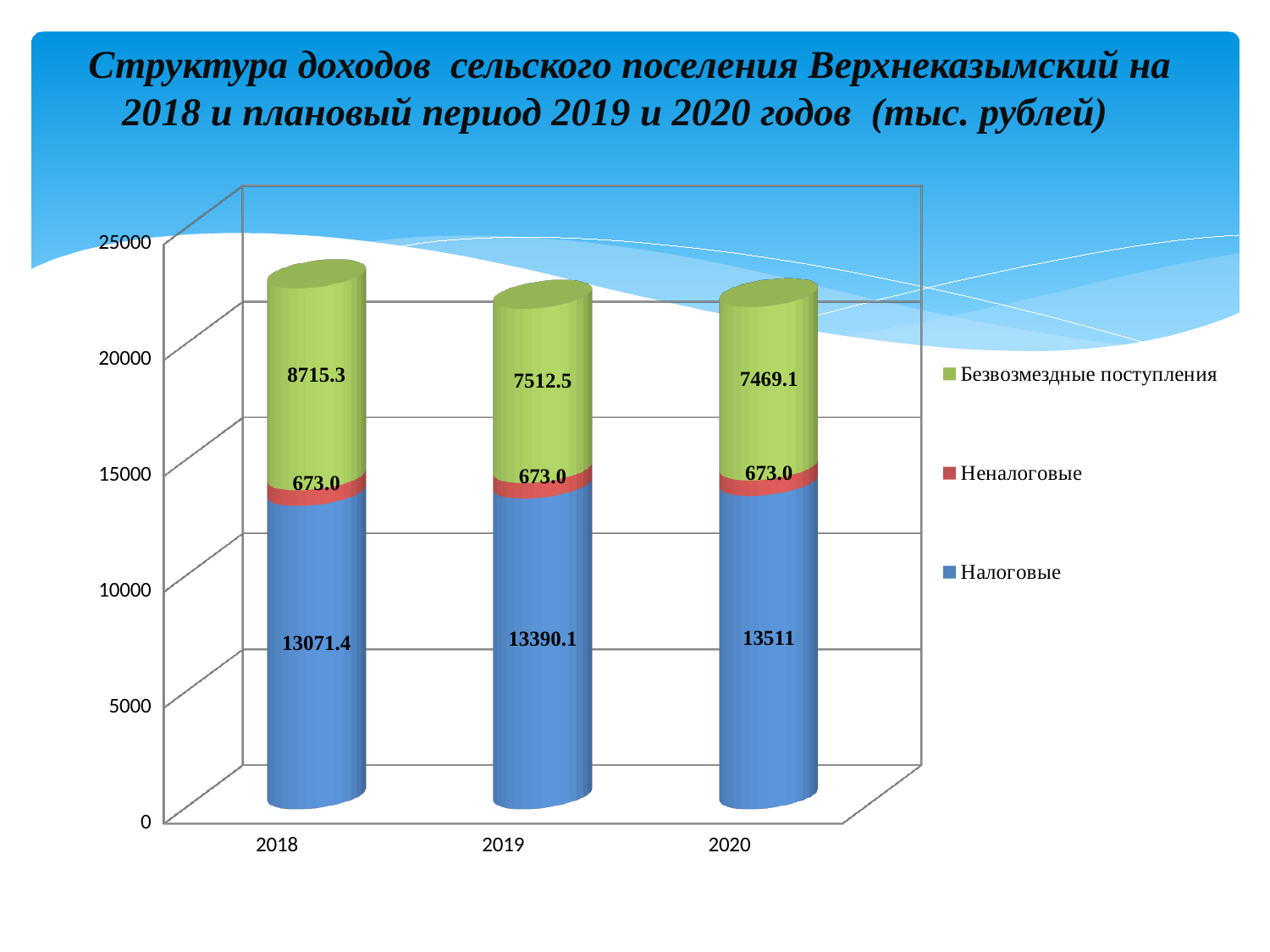
What type of chart is shown on the slide? stacked bar chart What is the difference between Безвозмездные поступления in 2018 and in 2019? 1202.8 In which year is Безвозмездные поступления highest? 2018 Does the value of Налоговые rise or fall from 2018 to 2020? rise How many years (categories) are shown on the x axis? 3 In which year is Налоговые lowest? 2018 Which is larger: Налоговые in 2020 or Налоговые in 2019? Налоговые in 2020 What is the value of Безвозмездные поступления for 2019? 7512.5 What is the value of Неналоговые for 2020? 673.0 How many series does the legend list? 3 What is the total of the stacked bar for 2018? 22459.7 What is the value of Налоговые for 2018? 13071.4